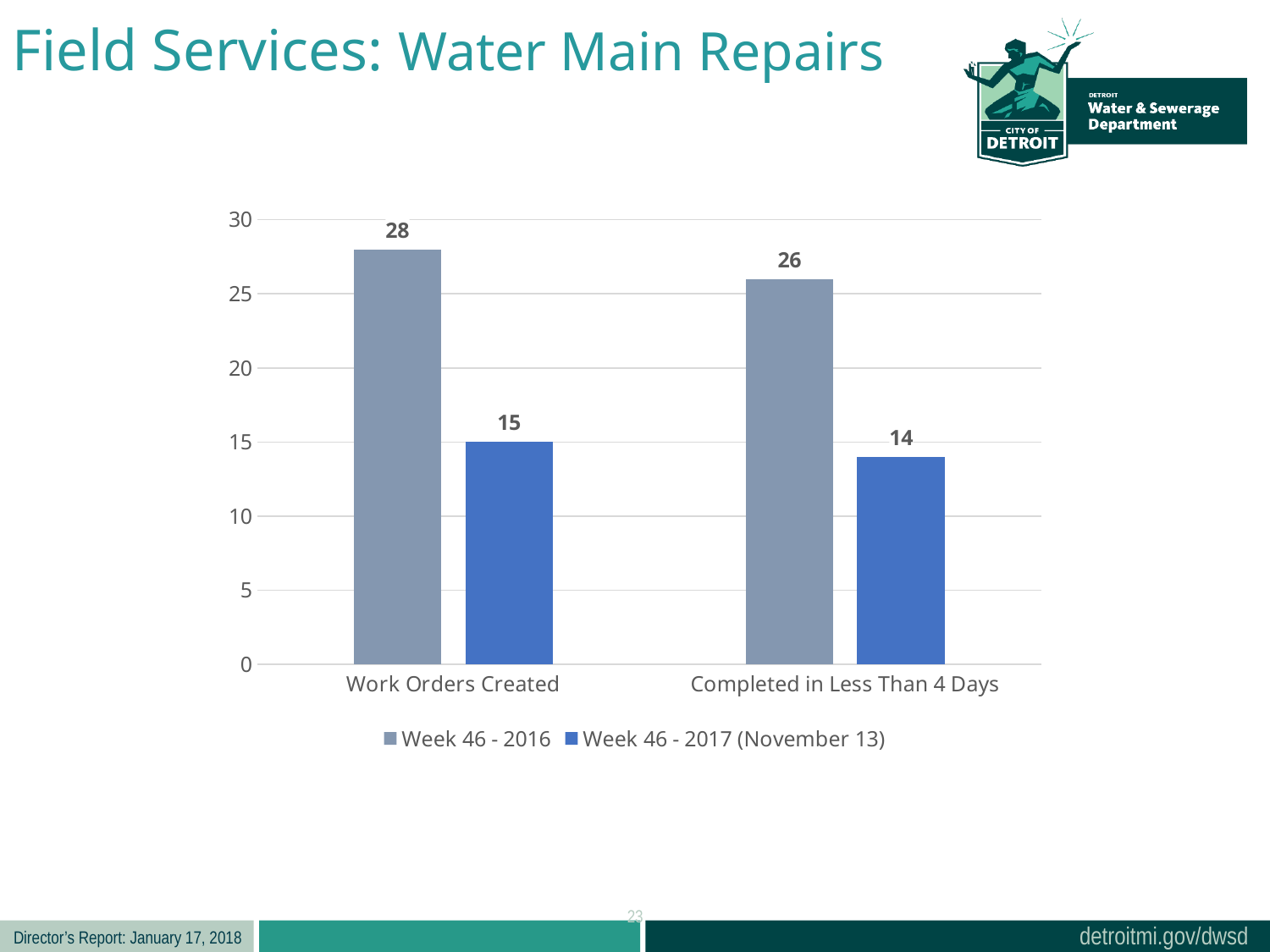
How many series does the legend list? 2 Which bar has the lowest value on the chart? Completed in Less Than 4 Days, Week 46 - 2017 (November 13) What is the value for Work Orders Created in Week 46 - 2016? 28 What kind of chart is shown on the slide? Bar chart Which is larger: Work Orders Created in Week 46 - 2016 or Completed in Less Than 4 Days in Week 46 - 2016? Work Orders Created in Week 46 - 2016 How many categories are shown on the x axis? 2 What is the value for Completed in Less Than 4 Days in Week 46 - 2016? 26 What is the value for Work Orders Created in Week 46 - 2017 (November 13)? 15 What is the difference between Completed in Less Than 4 Days in Week 46 - 2016 and Week 46 - 2017 (November 13)? 12 What is the value for Completed in Less Than 4 Days in Week 46 - 2017 (November 13)? 14 Which bar has the highest value on the chart? Work Orders Created, Week 46 - 2016 What is the difference between Work Orders Created in Week 46 - 2016 and Week 46 - 2017 (November 13)? 13